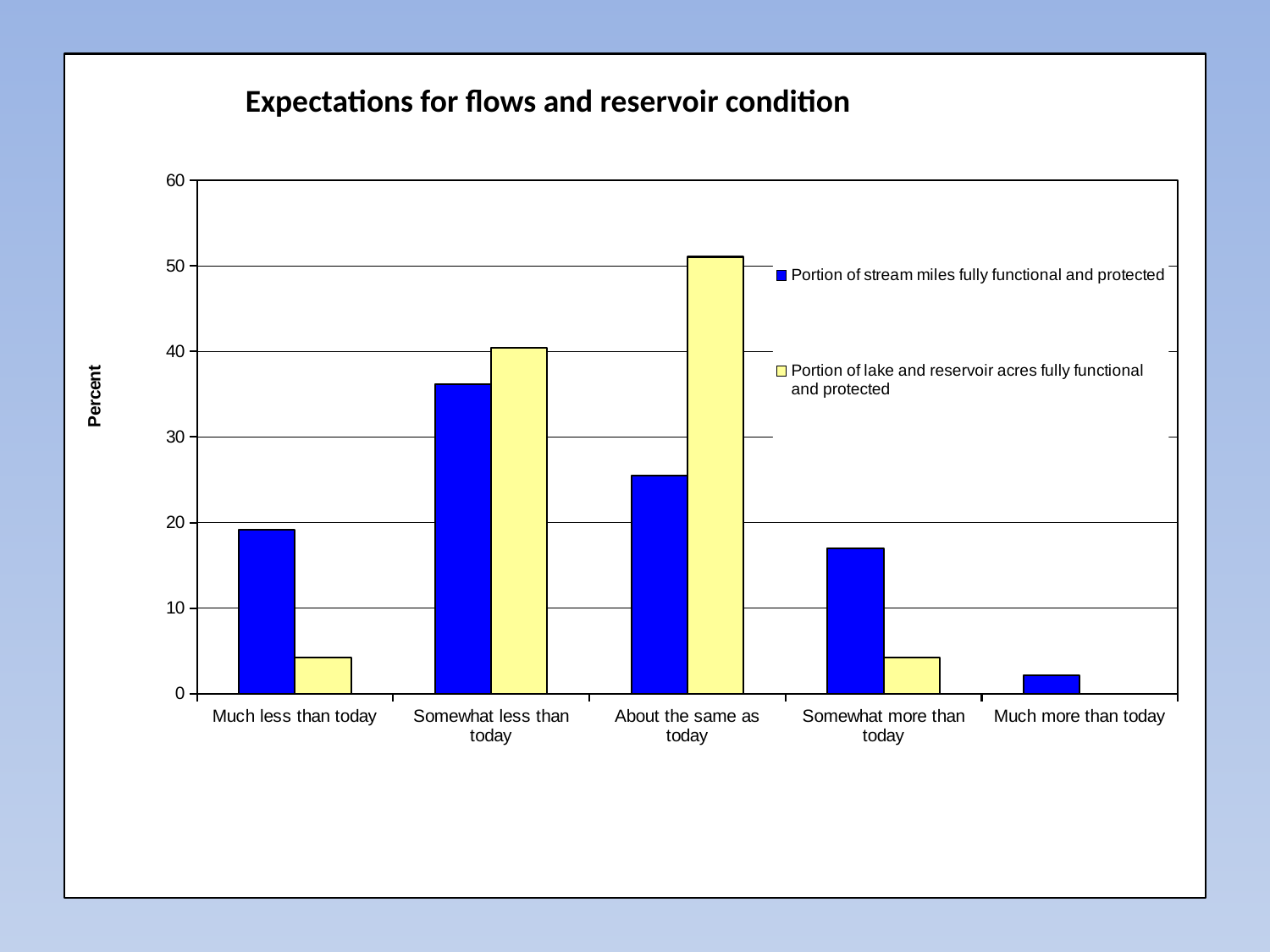
Which category has the lowest value for 'Portion of stream miles fully functional and protected'? Much more than today How many series does the legend list? 2 Which category has the highest value for 'Portion of lake and reservoir acres fully functional and protected'? About the same as today How many categories are shown on the x axis? 5 What is the title of the chart? Expectations for flows and reservoir condition Is the value for 'Portion of stream miles fully functional and protected' in 'Much less than today' greater or less than 20? less For 'About the same as today', which series has the larger value? Portion of lake and reservoir acres fully functional and protected Which category has the highest value for 'Portion of stream miles fully functional and protected'? Somewhat less than today Is the value for 'Portion of lake and reservoir acres fully functional and protected' in 'About the same as today' greater or less than 50? greater Is the value for 'Portion of stream miles fully functional and protected' in 'Somewhat less than today' greater or less than 30? greater What kind of chart is shown on the slide? bar chart For 'Somewhat more than today', which series has the larger value? Portion of stream miles fully functional and protected